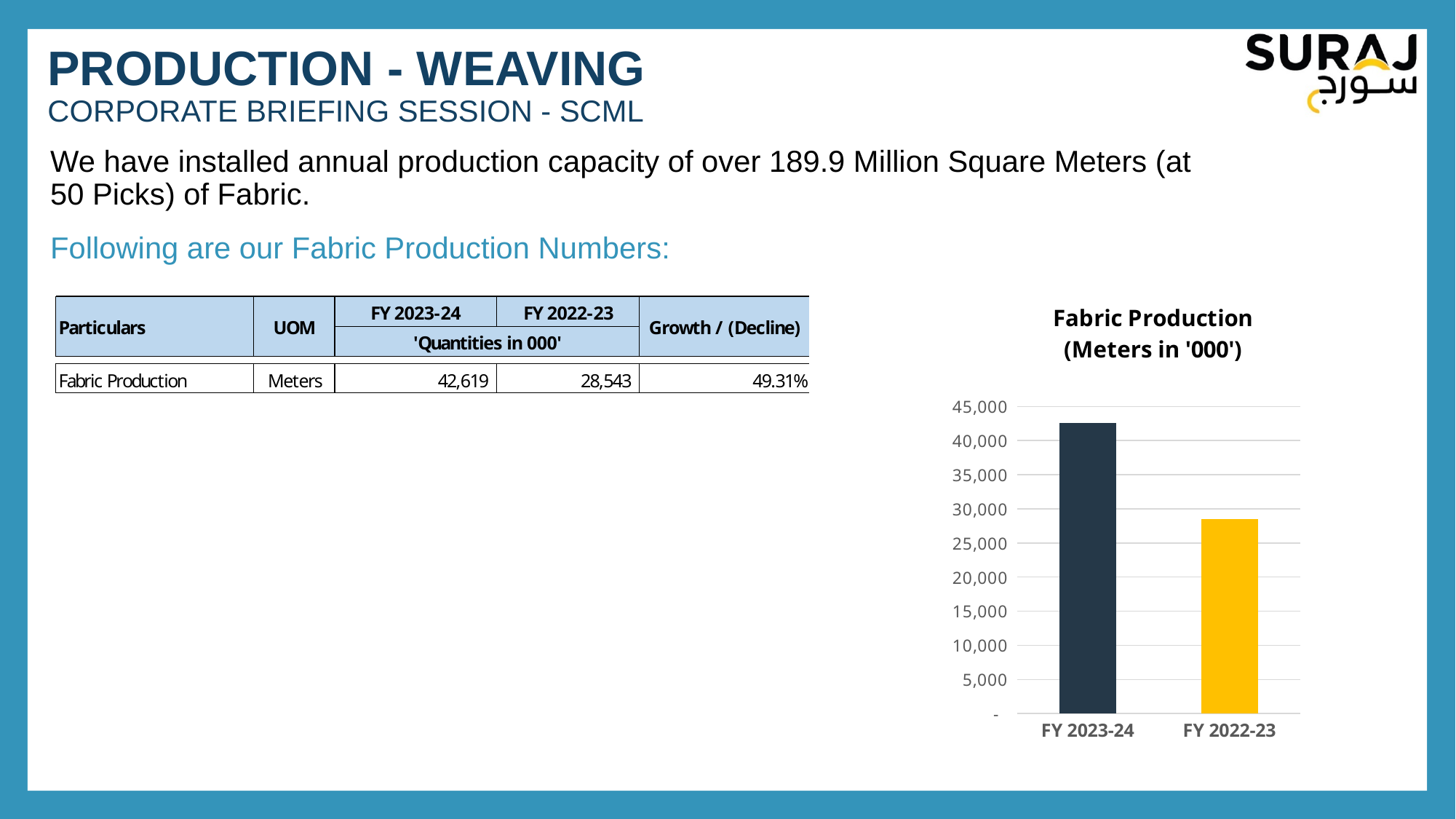
Which fiscal year has the highest fabric production in the chart? FY 2023-24 What colour is the bar for FY 2022-23 in the chart? yellow What is the title of the chart? Fabric Production (Meters in '000') What type of chart is shown on the slide? bar chart What is the fabric production value for FY 2022-23 (in '000 meters), as printed in the table on the slide? 28,543 Is the fabric production for FY 2022-23 greater or less than 30,000? less What is the fabric production value for FY 2023-24 (in '000 meters), as printed in the table on the slide? 42,619 Is the fabric production for FY 2023-24 greater or less than 40,000? greater Which is larger, the fabric production for FY 2023-24 or FY 2022-23? FY 2023-24 How many bars does the chart show? 2 Using the values printed in the table, what is the difference in fabric production between FY 2023-24 and FY 2022-23 (in '000 meters)? 14,076 Which fiscal year has the lowest fabric production in the chart? FY 2022-23